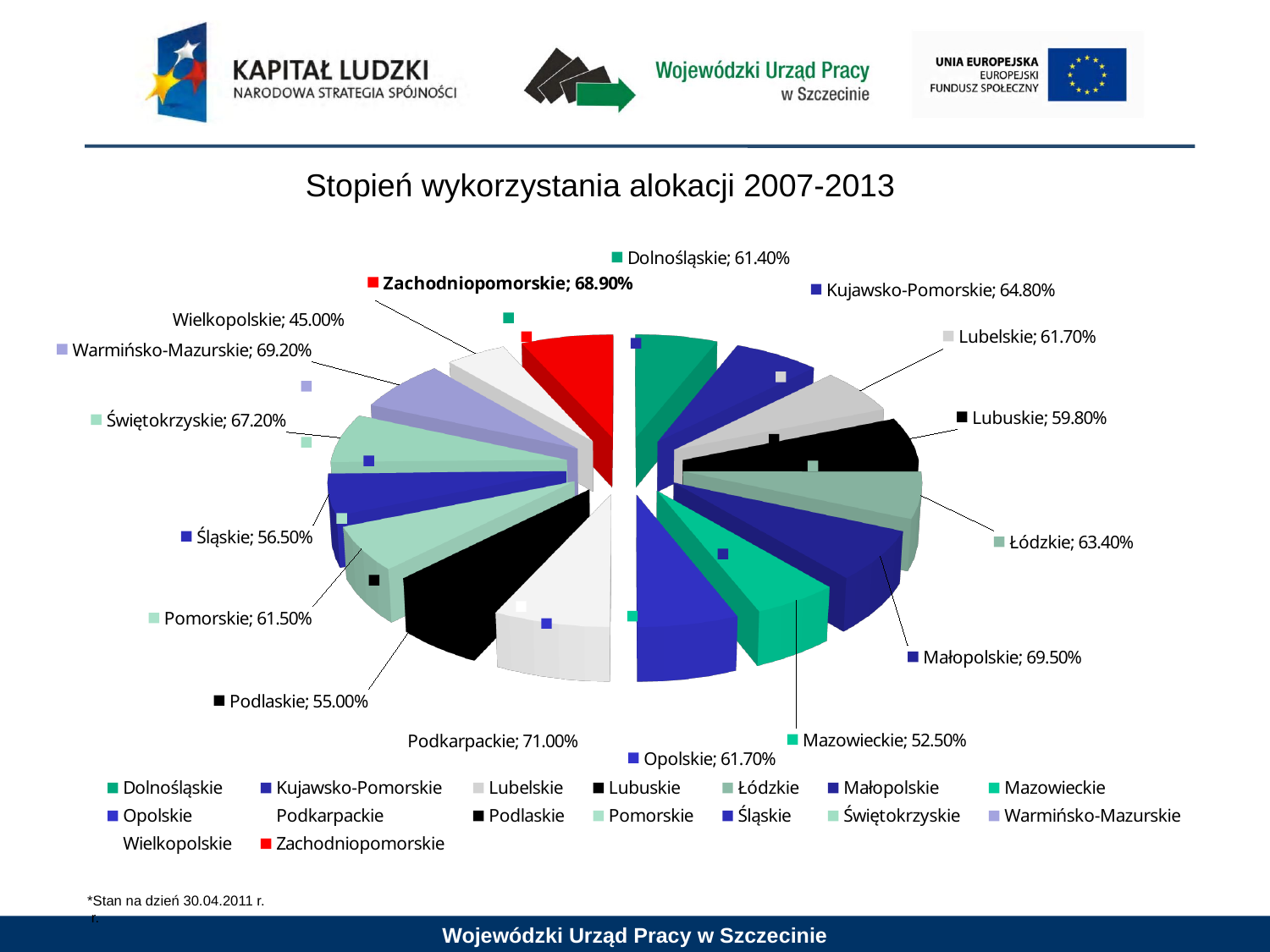
What is the value shown for Wielkopolskie? 45.00% Which region has the lowest value on the chart? Wielkopolskie What is the value shown for Mazowieckie? 52.50% What kind of chart is shown on the slide? Pie chart What is the difference between the values for Podkarpackie and Wielkopolskie? 26.00 percentage points What is the value shown for Łódzkie? 63.40% Which has a larger value, Małopolskie or Warmińsko-Mazurskie? Małopolskie What is the title of the chart? Stopień wykorzystania alokacji 2007-2013 What is the difference between the values for Zachodniopomorskie and Mazowieckie? 16.40 percentage points How many regions are shown on the chart? 16 What is the value shown for Zachodniopomorskie? 68.90% Which region has the highest value on the chart? Podkarpackie